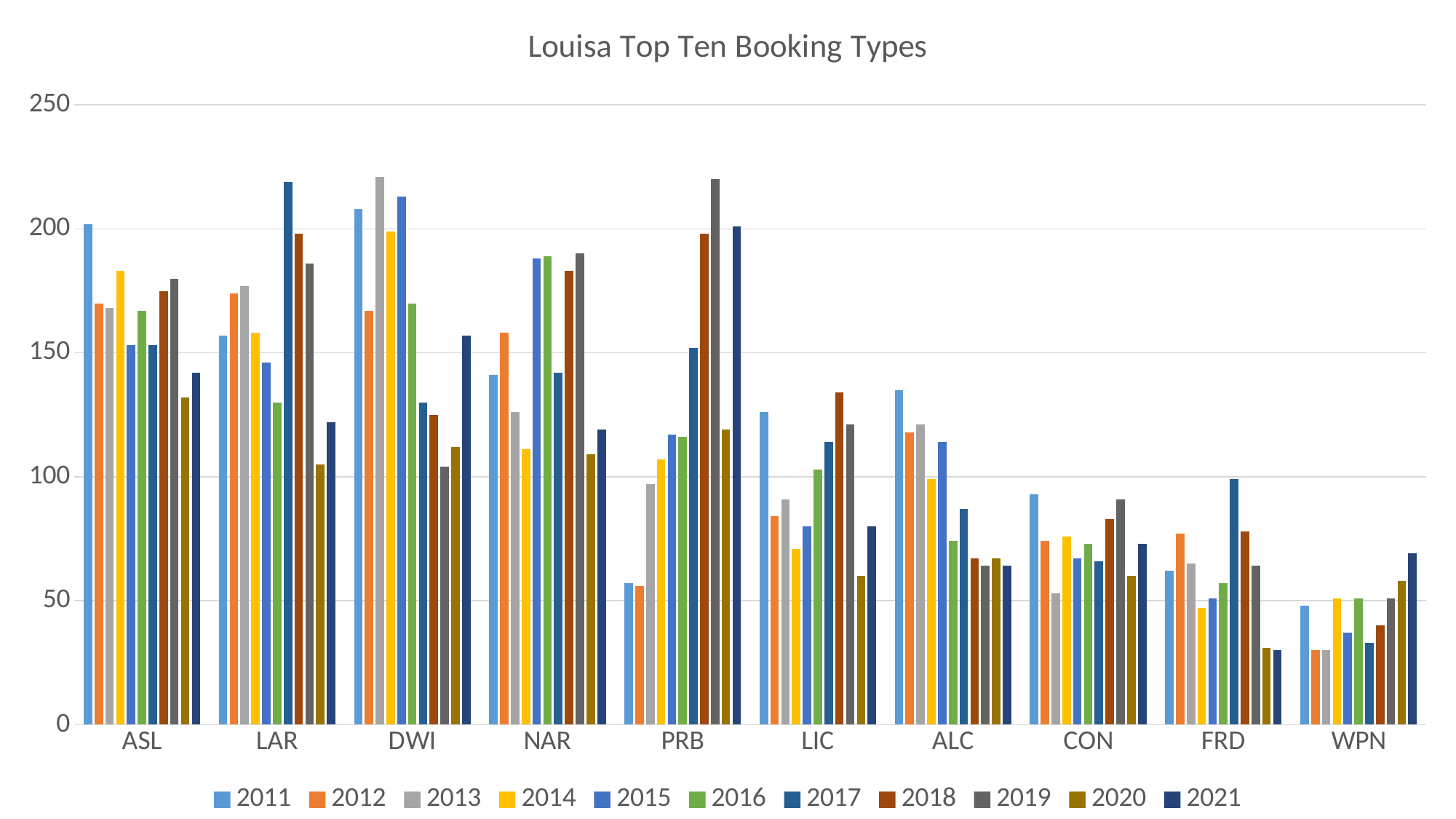
How many series (years) does the legend list? 11 How many booking type categories are shown on the x axis? 10 Is the value for WPN in 2012 greater or less than 50? less Is the value for PRB in 2012 greater or less than 100? less Is the value for LIC in 2018 greater or less than 100? greater Which is larger, the 2011 value for ASL or the 2011 value for LAR? ASL What kind of chart is shown on the slide? bar chart What is the title of the chart? Louisa Top Ten Booking Types Which year has the lowest value for LAR? 2020 Which year has the highest value for WPN? 2021 Which year has the highest value for FRD? 2017